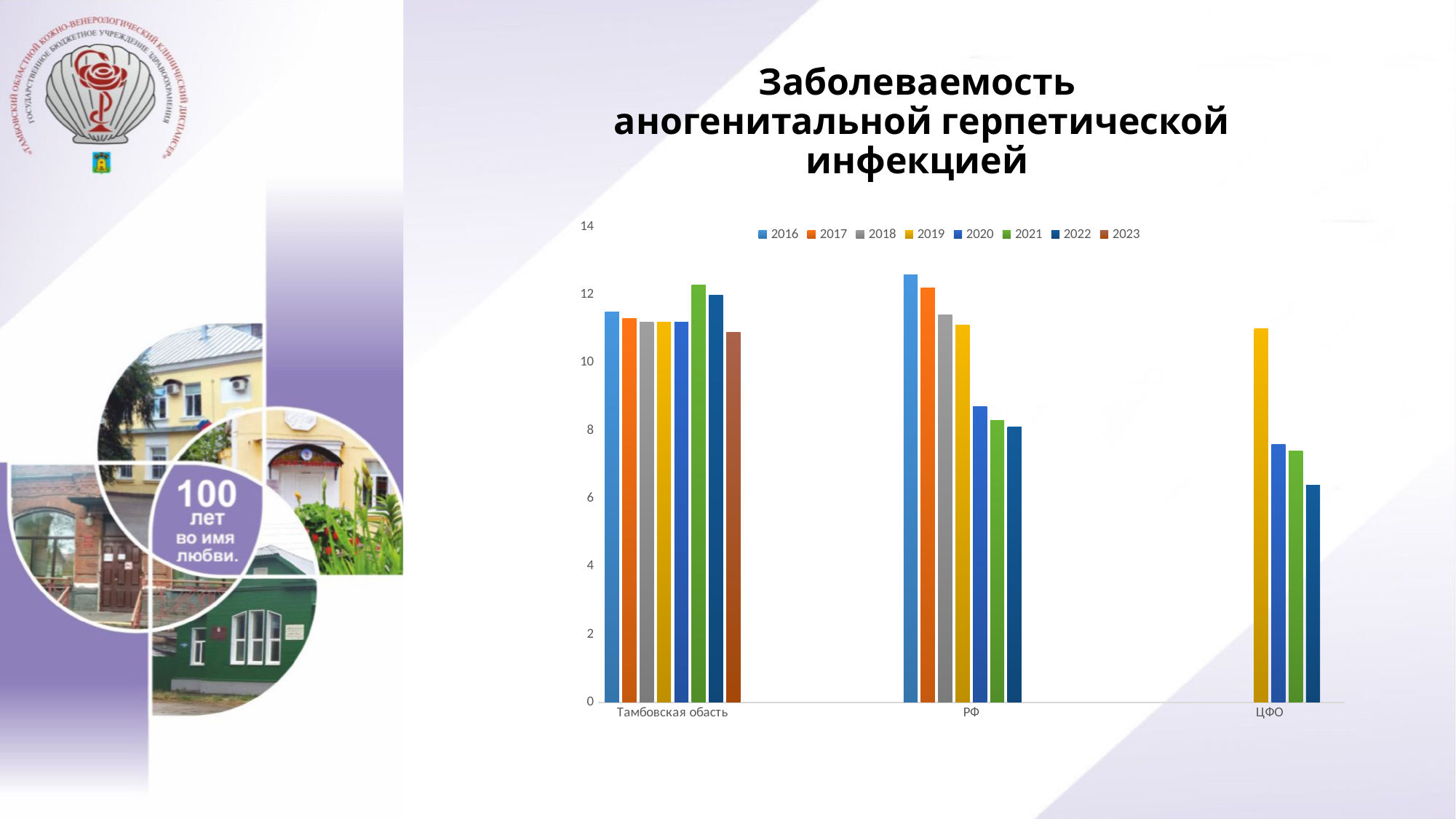
Is the value for РФ in 2022 greater or less than 10? less How many series does the legend list? 8 Which year has the highest value for РФ? 2016 How many categories are shown on the x axis? 3 Which year has the lowest value for ЦФО? 2022 Which is larger in 2016: the value for РФ or for Тамбовская область? РФ How many bars are plotted for the ЦФО category? 4 Which year has the highest value for ЦФО? 2019 What type of chart is shown on the slide? Bar chart Is the value for Тамбовская область in 2023 greater or less than 10? greater Is the value for ЦФО in 2022 greater or less than 8? less Which is larger in 2020: the value for РФ or for ЦФО? РФ